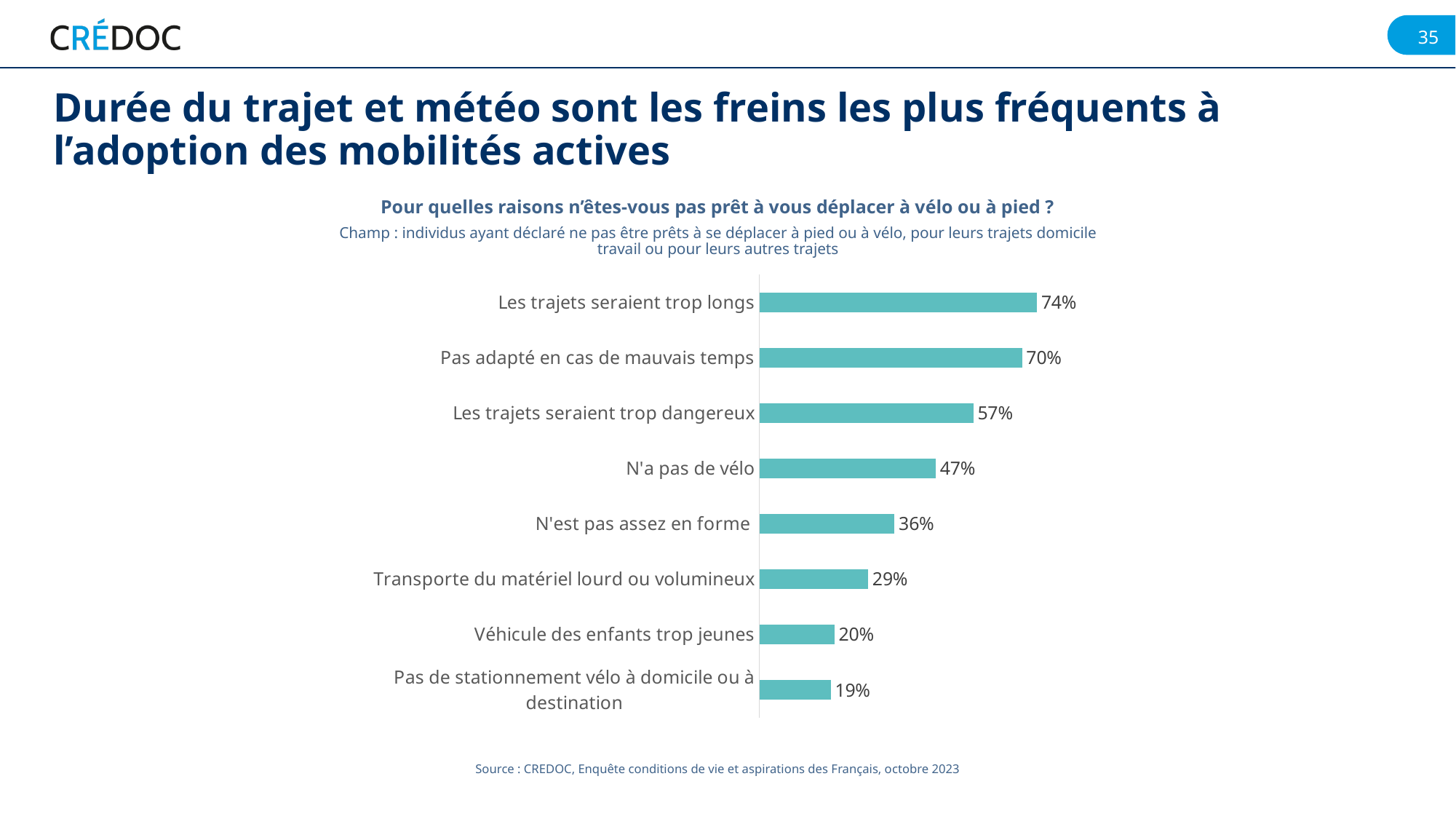
What kind of chart is shown on the slide? Bar chart Which is larger: 'N'est pas assez en forme' or 'Véhicule des enfants trop jeunes'? N'est pas assez en forme What is the value for 'N'a pas de vélo'? 47% What percentage of respondents said 'Les trajets seraient trop longs'? 74% What is the value for 'Véhicule des enfants trop jeunes'? 20% Which reason has the lowest percentage? Pas de stationnement vélo à domicile ou à destination Which reason has the highest percentage? Les trajets seraient trop longs What is the difference between 'Pas adapté en cas de mauvais temps' and 'Les trajets seraient trop dangereux'? 13 percentage points What percentage is shown for 'Transporte du matériel lourd ou volumineux'? 29% What is the difference between the highest and lowest values in the chart? 55 percentage points How many reasons (categories) are shown in the chart? 8 What is the source cited below the chart? CREDOC, Enquête conditions de vie et aspirations des Français, octobre 2023